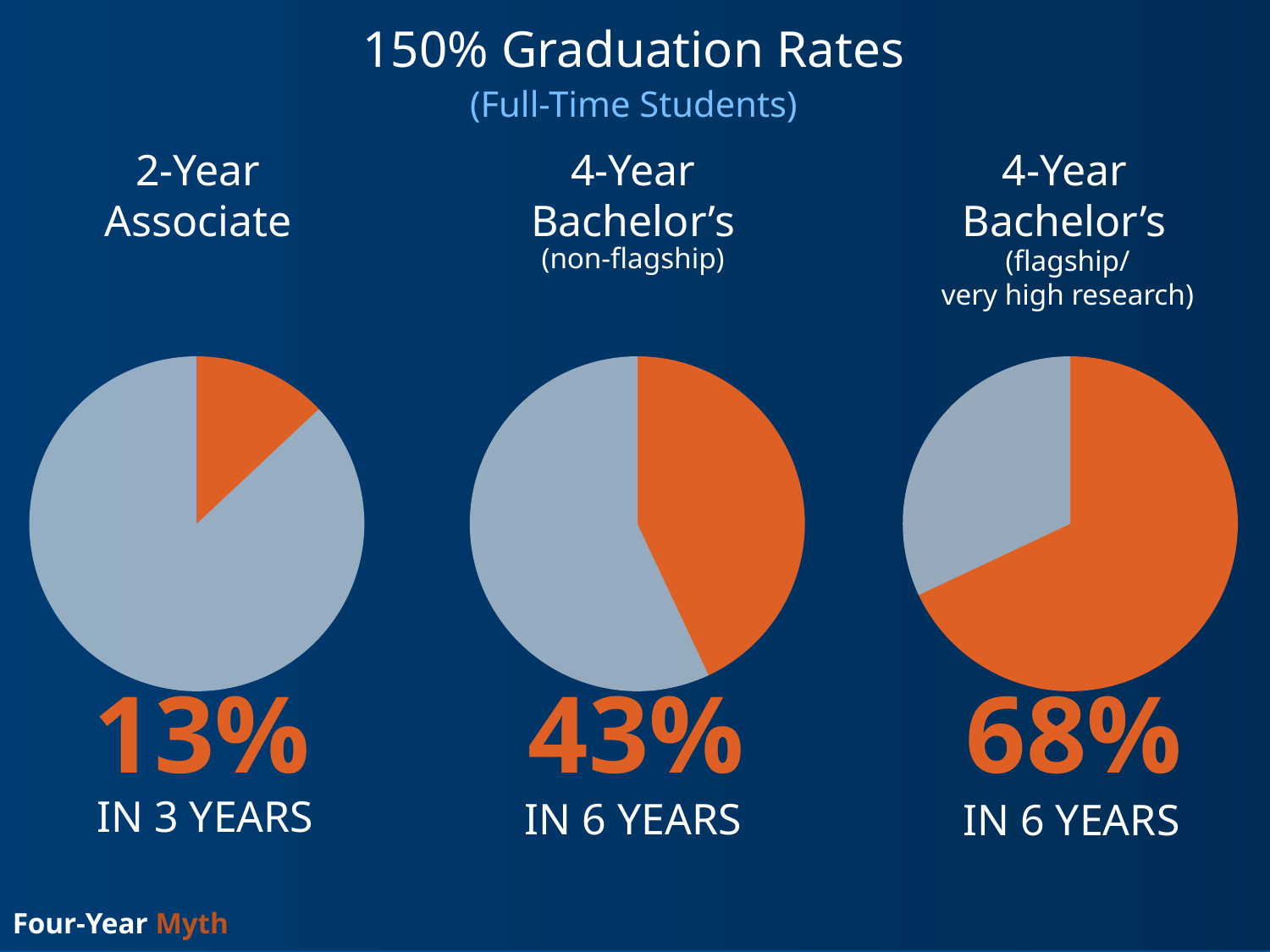
Which of the three groups has the lowest graduation rate? 2-Year Associate What is the 150% graduation rate shown for 4-Year Bachelor's (non-flagship) students? 43% Which of the three groups has the highest graduation rate? 4-Year Bachelor's (flagship/very high research) What kind of chart is used to show each graduation rate on this slide? Pie chart What is the 150% graduation rate shown for 2-Year Associate students? 13% What is the difference between the flagship and non-flagship 4-Year Bachelor's graduation rates? 25% What is the 150% graduation rate shown for 4-Year Bachelor's (flagship/very high research) students? 68% Which is larger, the 2-Year Associate rate or the 4-Year Bachelor's (non-flagship) rate? 4-Year Bachelor's (non-flagship) Over how many years is the 2-Year Associate graduation rate measured? 3 years What is the difference between the 4-Year Bachelor's (non-flagship) rate and the 2-Year Associate rate? 30% What colour is the slice representing the graduation rate in each pie chart? Orange How many pie charts are shown on the slide? 3